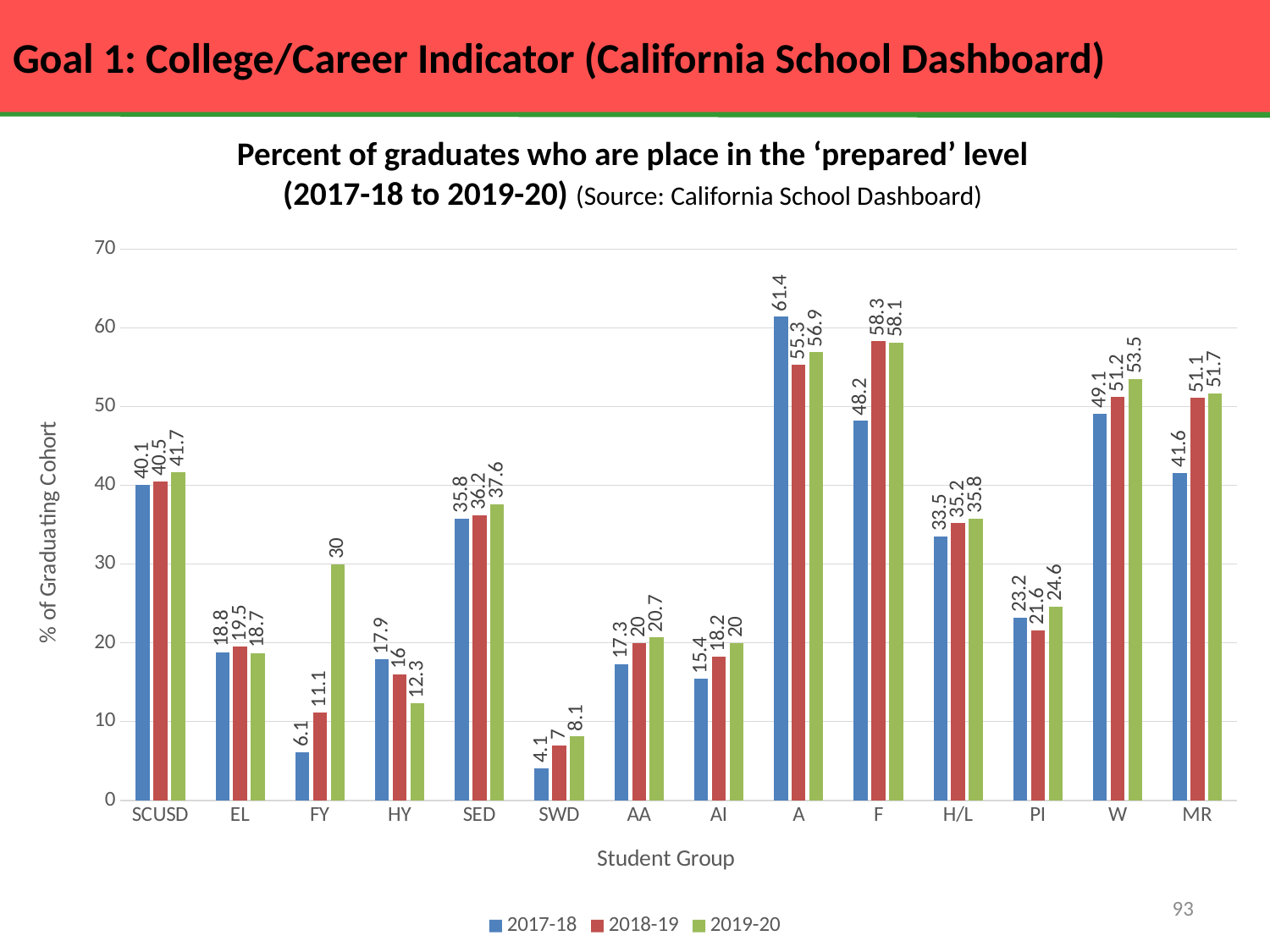
Do the values for HY rise or fall from 2017-18 to 2019-20? fall What is the 2017-18 value for A? 61.4 Which student group has the lowest 2019-20 value? SWD What is the difference between the 2019-20 and 2017-18 values for FY? 23.9 What is the 2019-20 value for FY? 30 How many series does the legend list? 3 What is the 2018-19 value for MR? 51.1 Which is larger, the 2018-19 value for F or the 2018-19 value for A? F Which student group has the highest 2017-18 value? A How many student groups are shown on the x axis? 14 What kind of chart is shown on the slide? bar chart Is the 2019-20 value for W greater or less than 50? greater